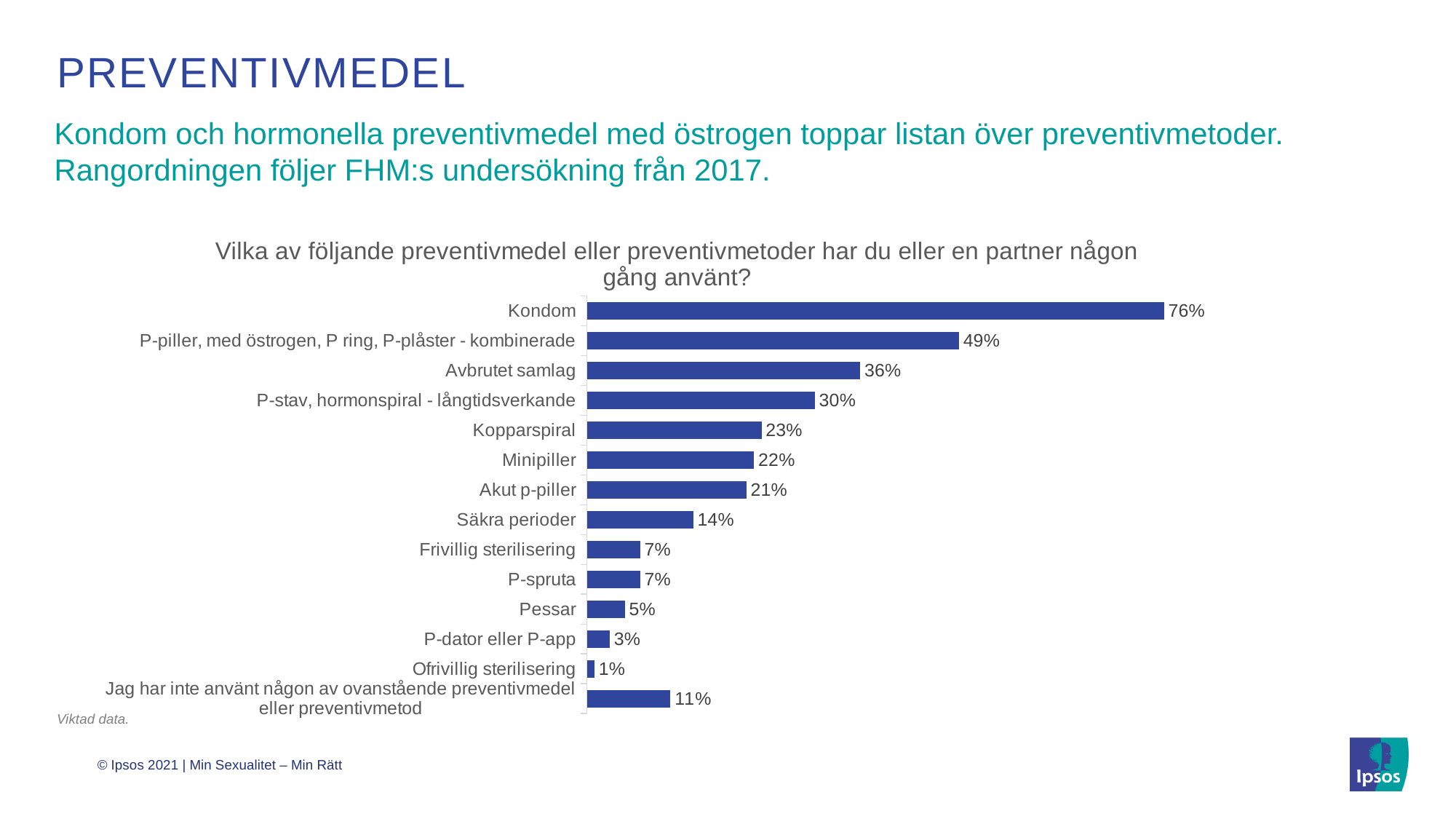
What is the value for Jag har inte använt någon av ovanstående preventivmedel eller preventivmetod? 11% What is the value for Pessar? 5% How many categories are shown in the chart? 14 Which category has the highest value? Kondom What kind of chart is shown on the slide? Bar chart Which category has the lowest value? Ofrivillig sterilisering What is the difference between the values for Kondom and P-piller, med östrogen, P ring, P-plåster - kombinerade? 27% What is the value for Avbrutet samlag? 36% What is the value for Kopparspiral? 23% Which is larger, the value for Säkra perioder or the value for Akut p-piller? Akut p-piller What is the title of the chart? Vilka av följande preventivmedel eller preventivmetoder har du eller en partner någon gång använt? What is the value for Kondom? 76%